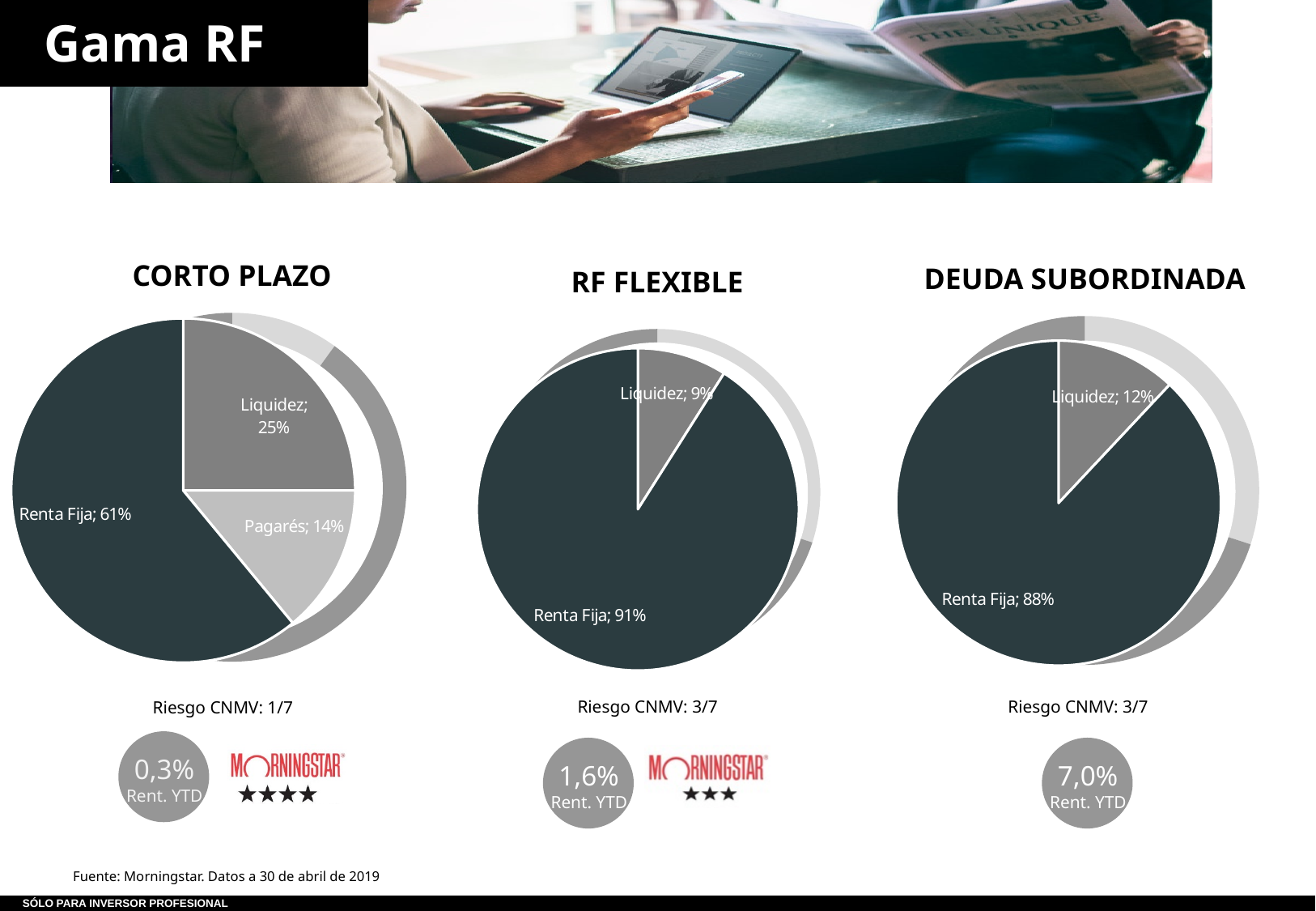
Which chart has the larger Liquidez share, RF FLEXIBLE or DEUDA SUBORDINADA? DEUDA SUBORDINADA In the CORTO PLAZO chart, what share does Liquidez have? 25% In the CORTO PLAZO chart, how many slices does the pie have? 3 In the CORTO PLAZO chart, what is the difference between the Renta Fija and Liquidez shares? 36% In the CORTO PLAZO chart, which slice is the smallest? Pagarés In the DEUDA SUBORDINADA chart, what share does Renta Fija have? 88% In the CORTO PLAZO chart, what share does Renta Fija have? 61% What type of chart is the RF FLEXIBLE chart? Pie chart In the RF FLEXIBLE chart, which slice is the largest? Renta Fija In the RF FLEXIBLE chart, what share does Liquidez have? 9% In the DEUDA SUBORDINADA chart, what share does Liquidez have? 12% In the CORTO PLAZO chart, what share does Pagarés have? 14%